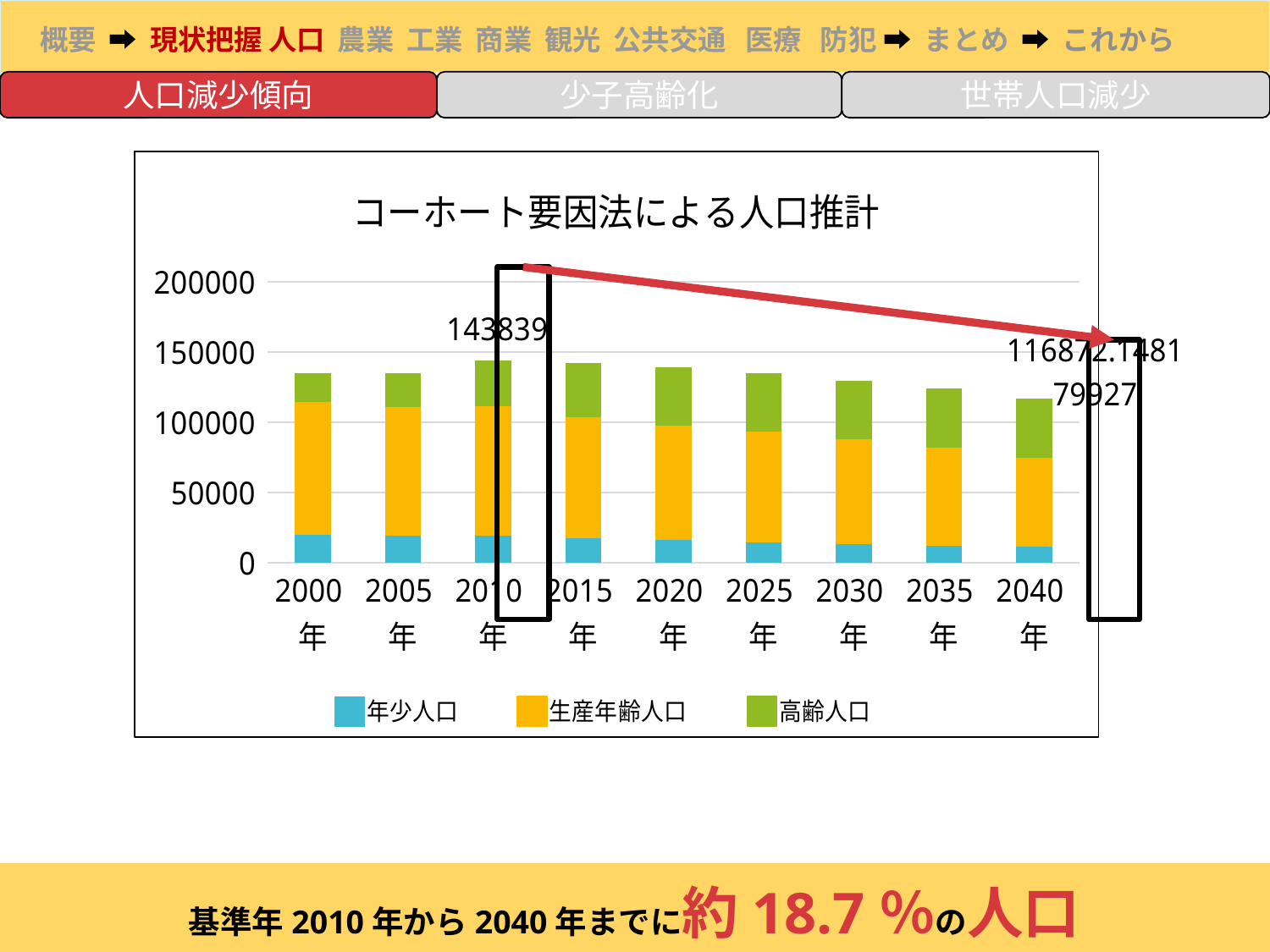
How many years are shown on the x axis? 9 How many series does the legend list? 3 What is the title of the chart? コーホート要因法による人口推計 What is the total population shown for 2040年? 116872.1481 Do the total populations rise or fall from 2010年 to 2040年? fall Which year has the lowest total population? 2040年 What is the total population shown for 2010年? 143839 Which series are listed in the legend? 年少人口, 生産年齢人口, 高齢人口 What kind of chart is shown on the slide? bar chart Is the total population for 2000年 greater or less than 150000? less What is the difference between the total for 2010年 and the total for 2040年? 26966.8519 Which year has the larger total population, 2020年 or 2035年? 2020年